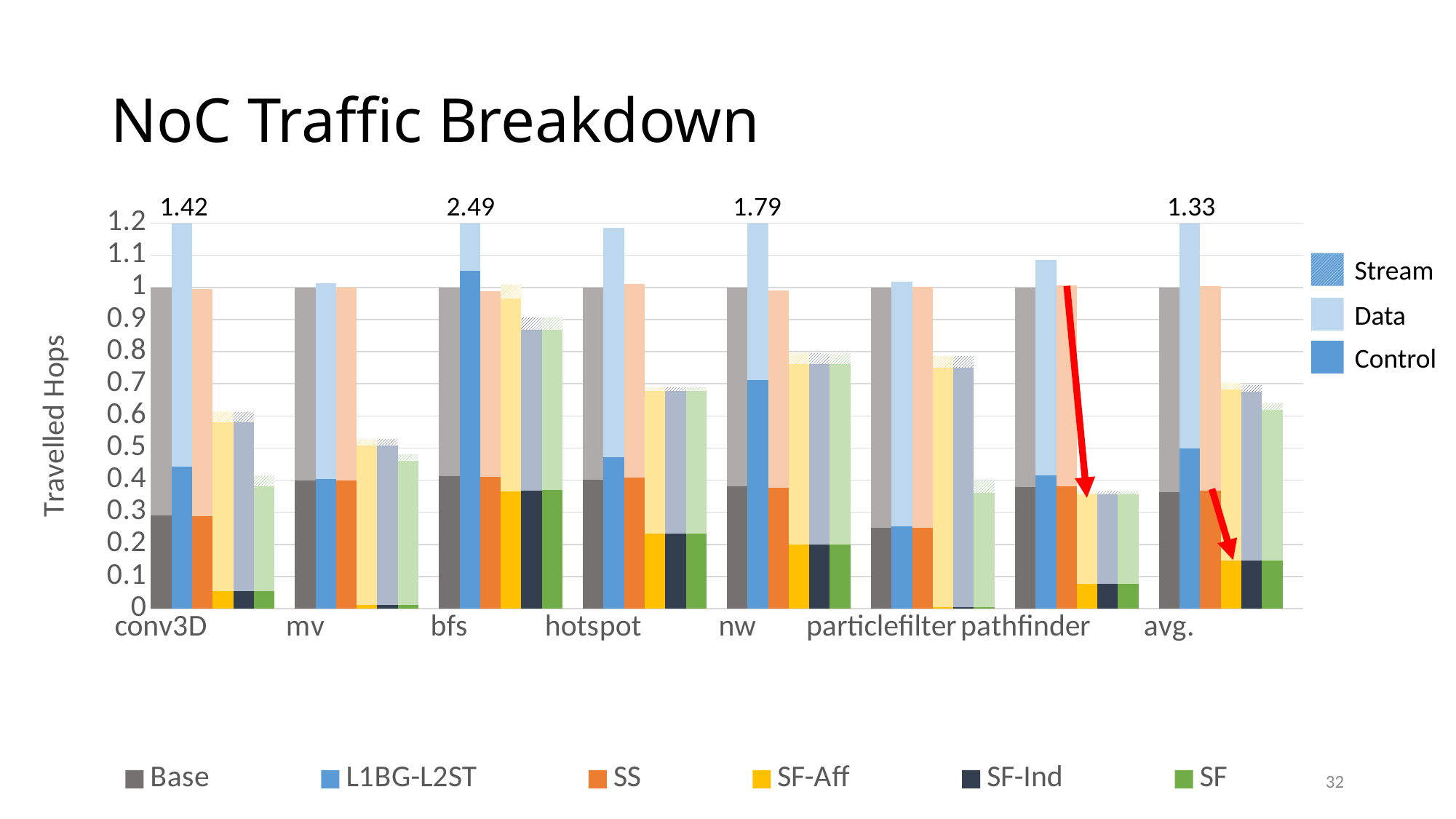
What is the difference between the labelled L1BG-L2ST values for bfs and conv3D? 1.07 Is the SF bar for pathfinder greater or less than 0.5? less How many benchmark categories are shown along the x axis? 8 What is the labelled value of the L1BG-L2ST bar for conv3D? 1.42 How many series does the legend at the bottom of the chart list? 6 What is the labelled value of the L1BG-L2ST bar for avg.? 1.33 What kind of chart is shown on the slide? bar chart Among the bars with printed value labels, which benchmark has the highest value? bfs What is the labelled value of the L1BG-L2ST bar for bfs? 2.49 For pathfinder, which is larger: the Base bar or the SF bar? Base What is the labelled value of the L1BG-L2ST bar for nw? 1.79 What is the title of the y axis? Travelled Hops